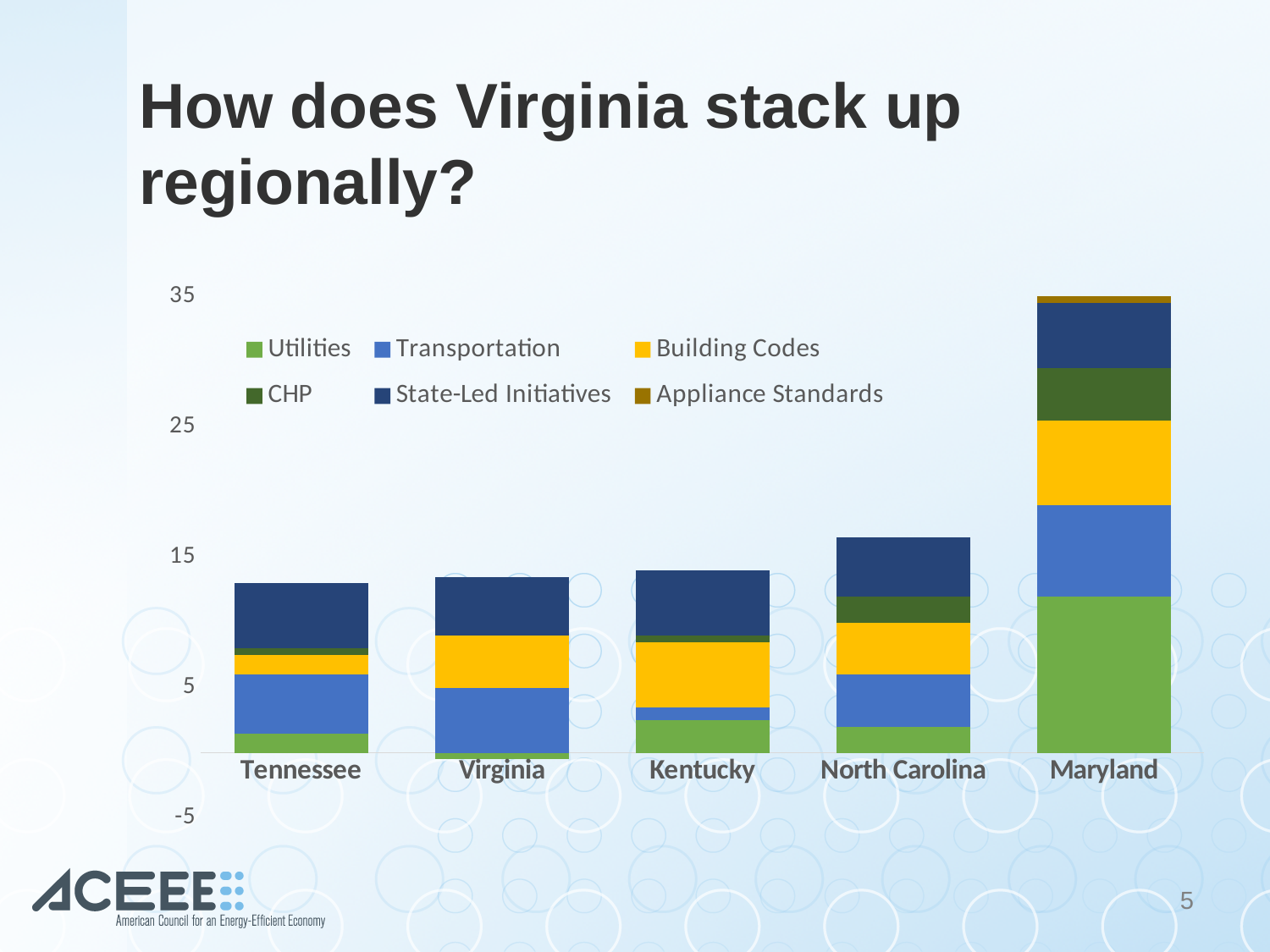
Is the total for North Carolina greater or less than 25? less How many series does the chart's legend list? 6 Which has the larger total bar, Maryland or North Carolina? Maryland Is the total for Maryland greater or less than 25? greater How many states (categories) are shown on the x axis of the chart? 5 Is the total for Virginia greater or less than 15? less Which series is shown in yellow in the chart's legend? Building Codes Do the total bar heights generally rise or fall from left to right across the states? rise What kind of chart is shown on the slide? Stacked bar chart Which state has the highest total stacked bar? Maryland Which has the larger total bar, North Carolina or Tennessee? North Carolina